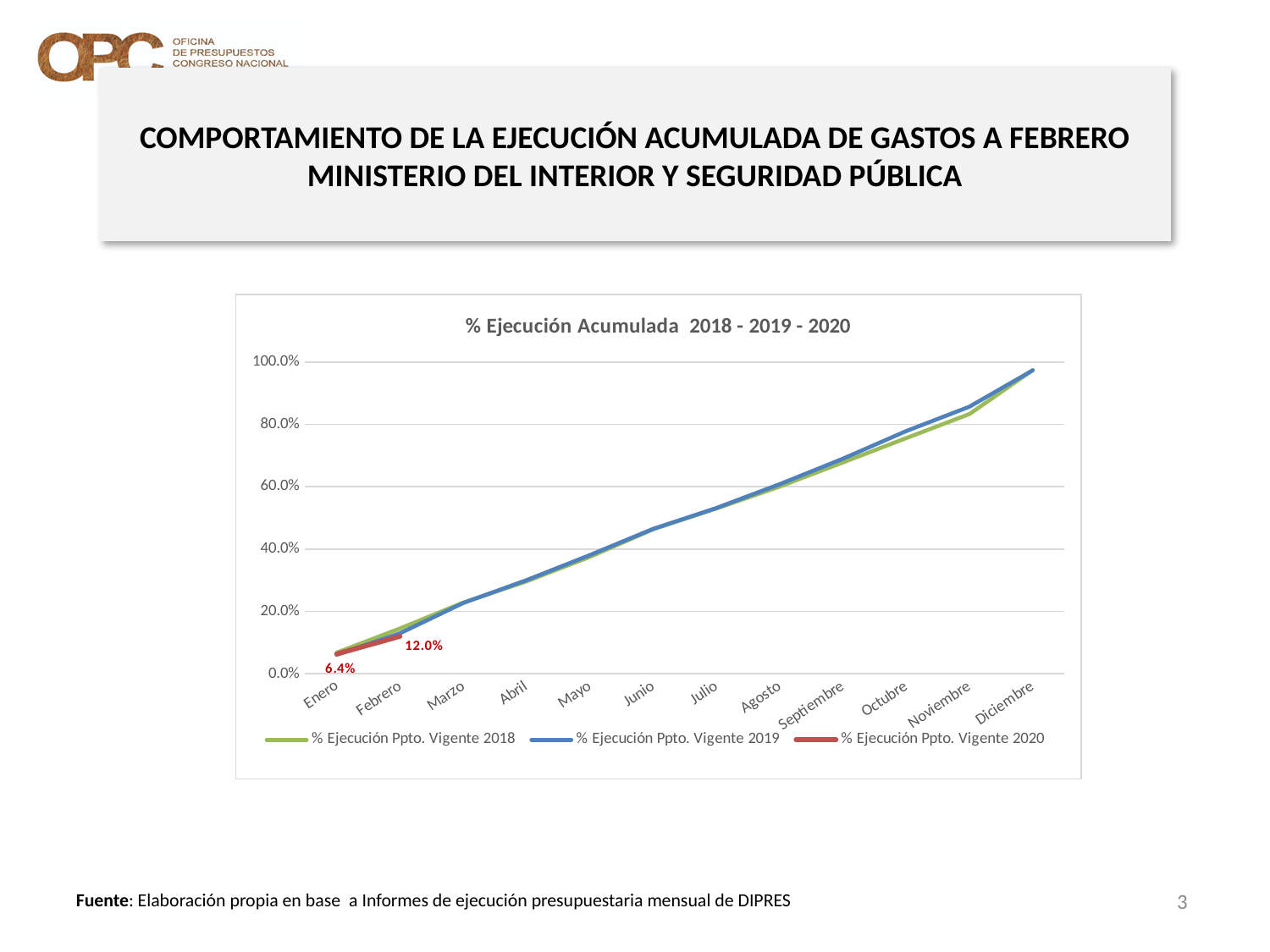
What is the value for % Ejecución Ppto. Vigente 2020 in Febrero? 12.0% Is the value for % Ejecución Ppto. Vigente 2019 in Marzo greater or less than 40.0%? less What colour is the line for % Ejecución Ppto. Vigente 2020? red What is the value for % Ejecución Ppto. Vigente 2020 in Enero? 6.4% How many months are shown along the x axis? 12 What is the title of the chart? % Ejecución Acumulada 2018 - 2019 - 2020 Do the values for % Ejecución Ppto. Vigente 2019 rise or fall from Enero to Diciembre? rise Is the value for % Ejecución Ppto. Vigente 2019 in Diciembre greater or less than 80.0%? greater What kind of chart is shown on the slide? line chart How many series does the legend list? 3 What is the difference between the Febrero and Enero values for % Ejecución Ppto. Vigente 2020? 5.6% Is the value for % Ejecución Ppto. Vigente 2018 in Junio greater or less than 60.0%? less